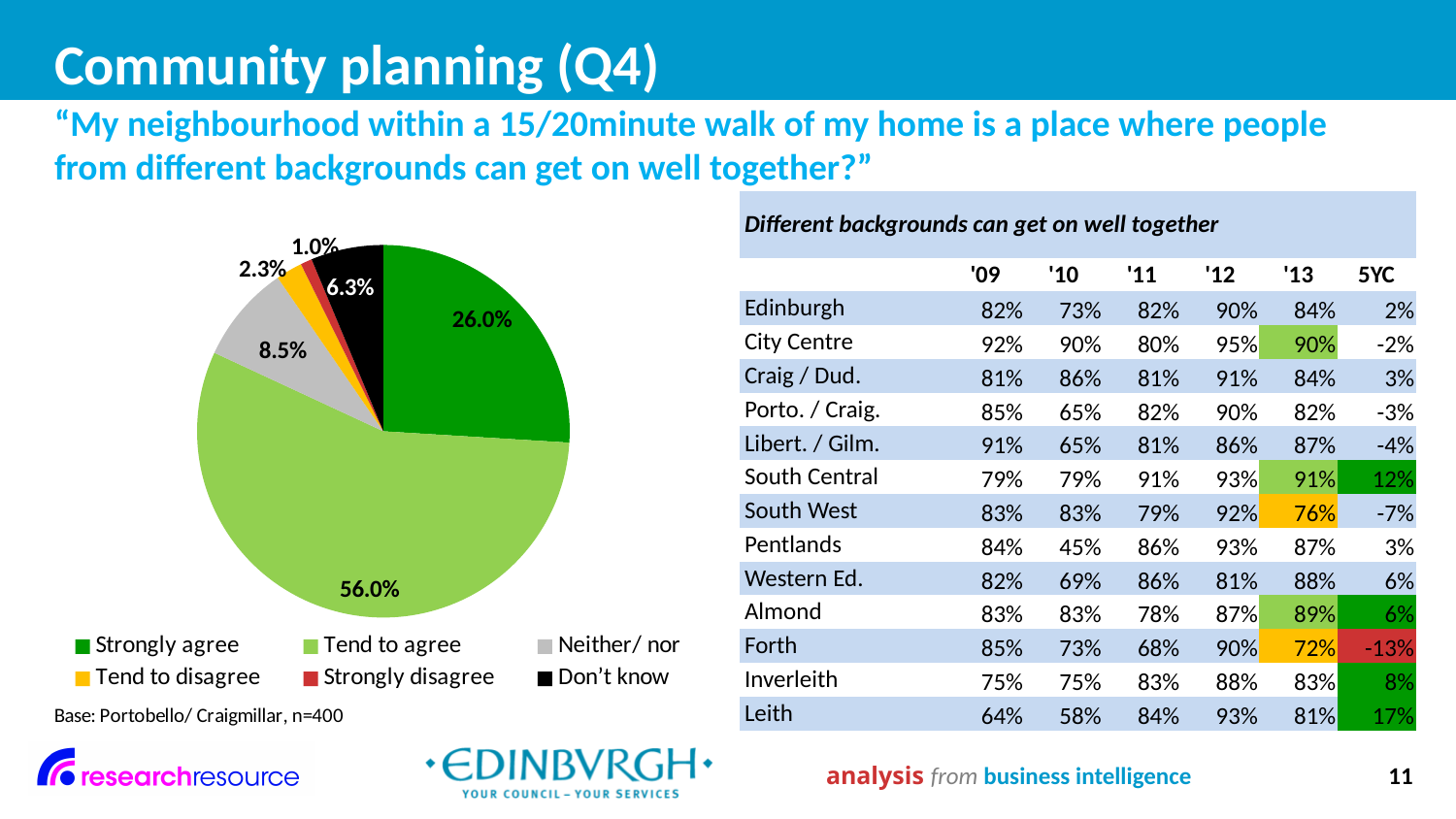
What percentage of respondents said 'Strongly disagree'? 1.0% What percentage of respondents answered 'Neither/ nor'? 8.5% What percentage of respondents said 'Strongly agree'? 26.0% What percentage of respondents said 'Tend to agree'? 56.0% What is the difference in percentage points between 'Tend to agree' and 'Strongly agree'? 30.0% How many response categories does the legend list? 6 Which response category has the smallest share of the pie? Strongly disagree What percentage of respondents answered 'Don't know'? 6.3% What is the base (sample size) stated below the pie chart? Portobello/ Craigmillar, n=400 What type of chart is shown on the slide? Pie chart Which response category has the largest share of the pie? Tend to agree Which is larger: the share for 'Don't know' or the share for 'Tend to disagree'? Don't know